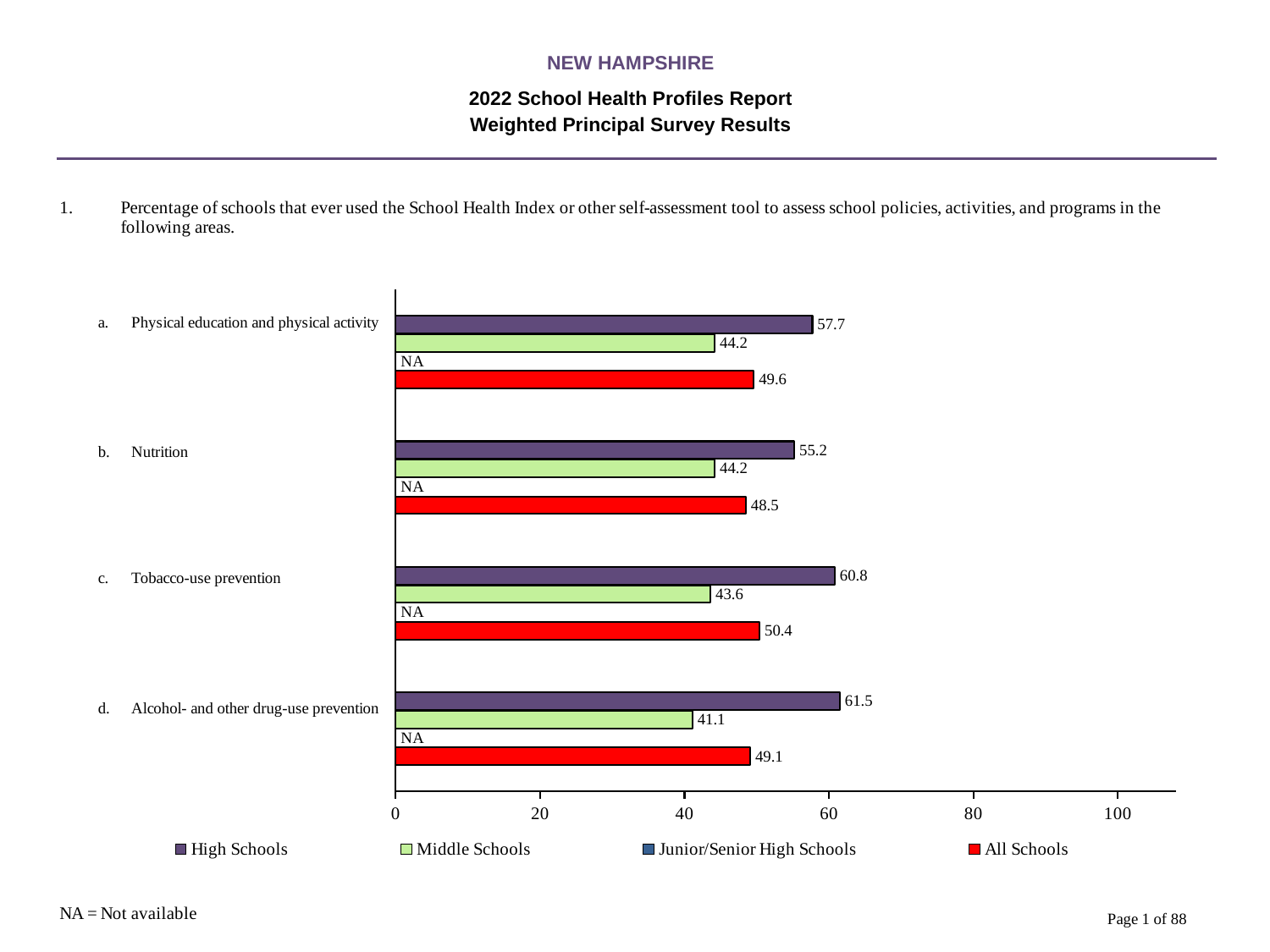
How many series does the legend list? 4 How many categories are shown on the chart? 4 Which series is shown in red in the legend? All Schools What is the value for Middle Schools for Alcohol- and other drug-use prevention? 41.1 Which category has the highest value for High Schools? Alcohol- and other drug-use prevention Which category has the lowest value for Middle Schools? Alcohol- and other drug-use prevention What is the value for All Schools for Nutrition? 48.5 What is the difference between the High Schools and Middle Schools values for Physical education and physical activity? 13.5 What is the value for High Schools for Tobacco-use prevention? 60.8 Which is larger for Nutrition: the High Schools value or the All Schools value? High Schools What is the value for Junior/Senior High Schools for Physical education and physical activity? NA What kind of chart is shown on the slide? bar chart